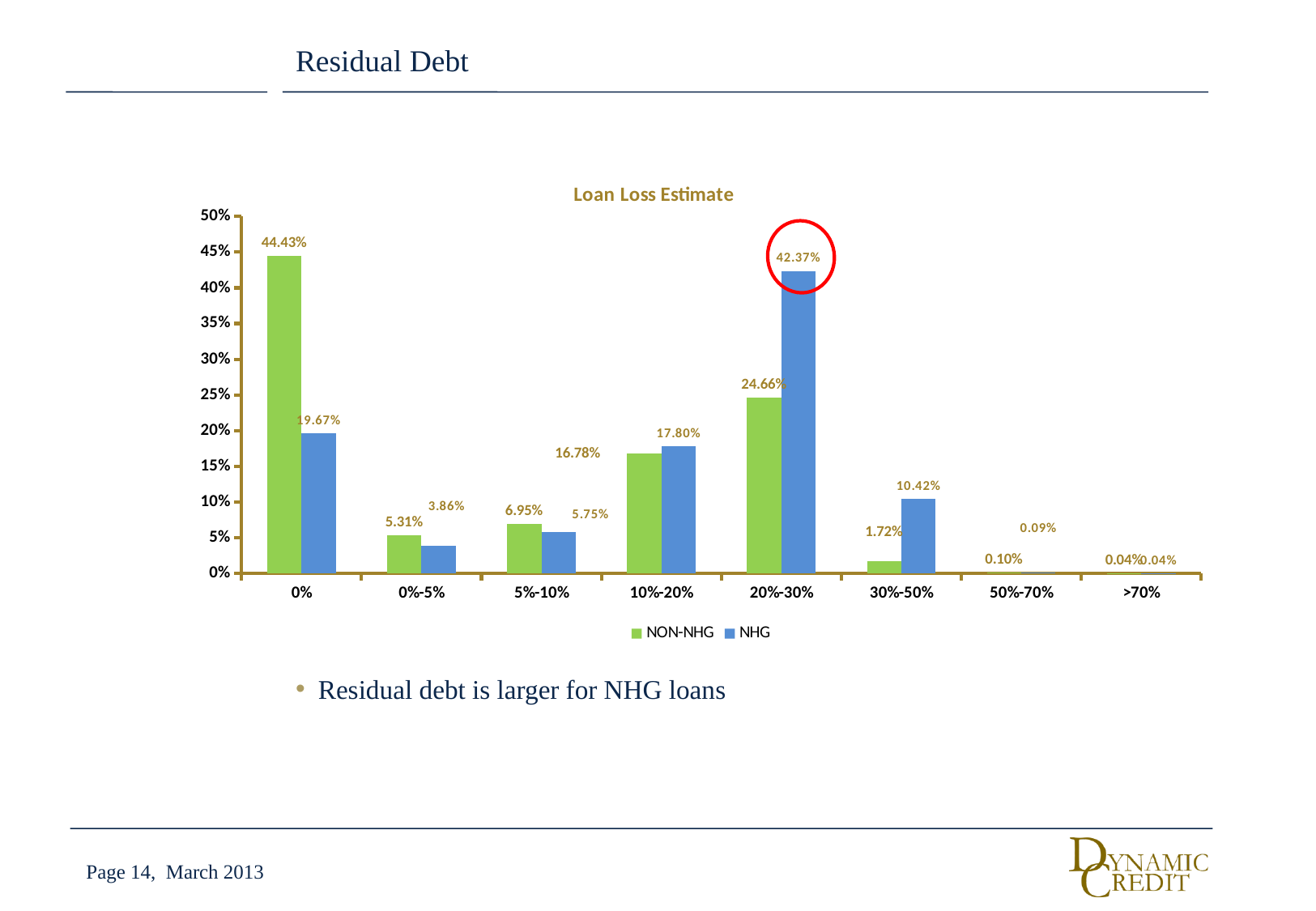
What is the NON-NHG value for the 0% category? 44.43% What is the NHG value for the 20%-30% category? 42.37% What is the difference between the NHG and NON-NHG values in the 20%-30% category? 17.71% Which category has the highest NHG value? 20%-30% What is the difference between the NON-NHG and NHG values in the 0% category? 24.76% How many series does the legend list? 2 Which category has the highest NON-NHG value? 0% How many categories are shown on the x axis? 8 What kind of chart is shown on the slide? Bar chart What is the title of the chart? Loan Loss Estimate What is the NHG value for the 30%-50% category? 10.42% In the 10%-20% category, which series has the larger value, NON-NHG or NHG? NHG